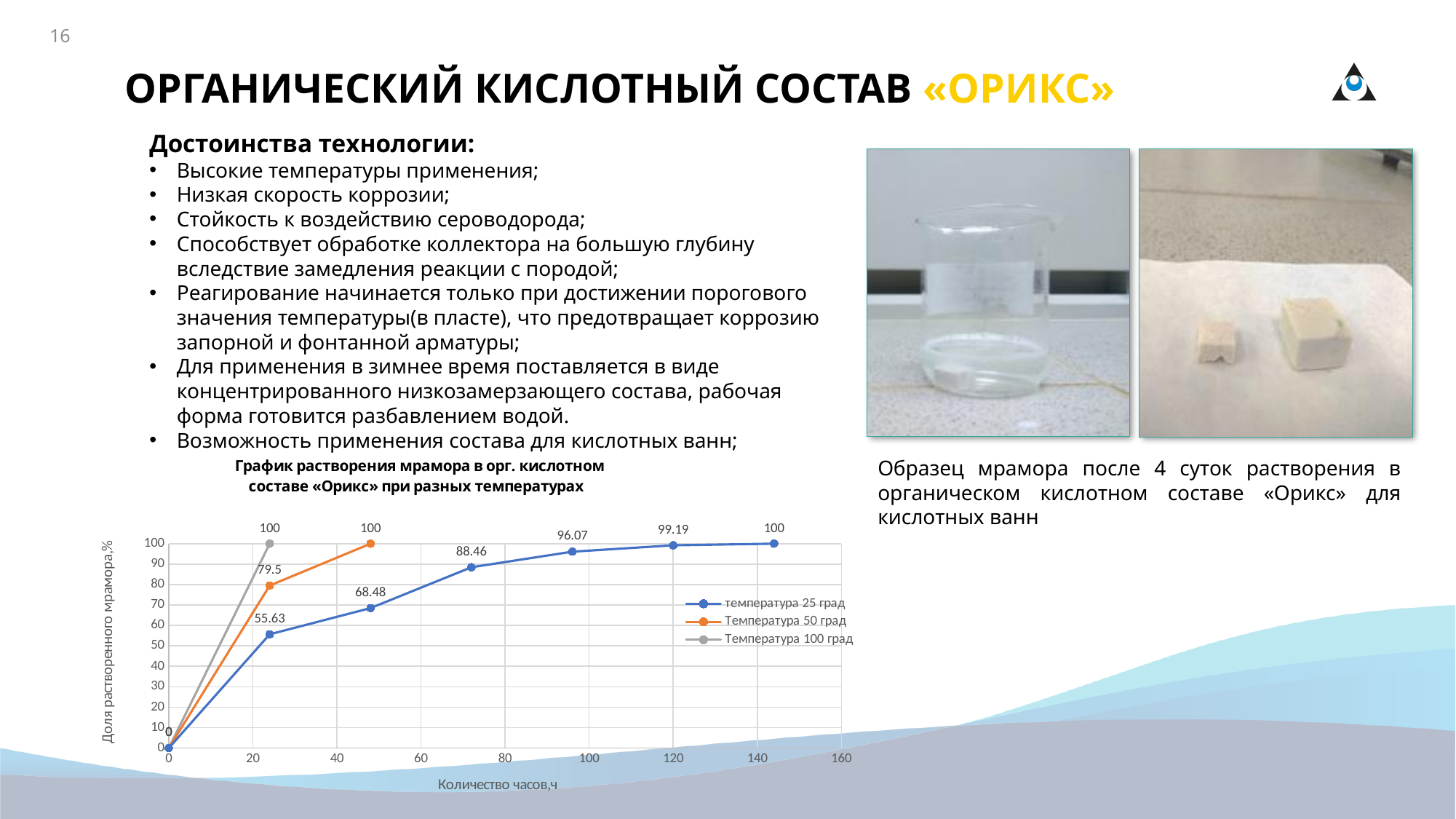
What is the label of the chart's x axis? Количество часов,ч Does the 'температура 25 град' series rise or fall as the number of hours increases? rise What is the value for the 'температура 25 град' series at 72 hours? 88.46 What is the value for the 'Температура 100 град' series at 24 hours? 100 How many series does the chart legend list? 3 What is the value for the 'температура 25 град' series at 24 hours? 55.63 What kind of chart is shown on the slide? line chart How many data points are plotted for the 'температура 25 град' series? 7 What is the value for the 'температура 25 град' series at 120 hours? 99.19 What is the value for the 'Температура 50 град' series at 24 hours? 79.5 At 24 hours, which series has the higher value: 'температура 25 град' or 'Температура 100 град'? Температура 100 град What is the difference between the 'Температура 50 град' and 'температура 25 град' values at 24 hours? 23.87